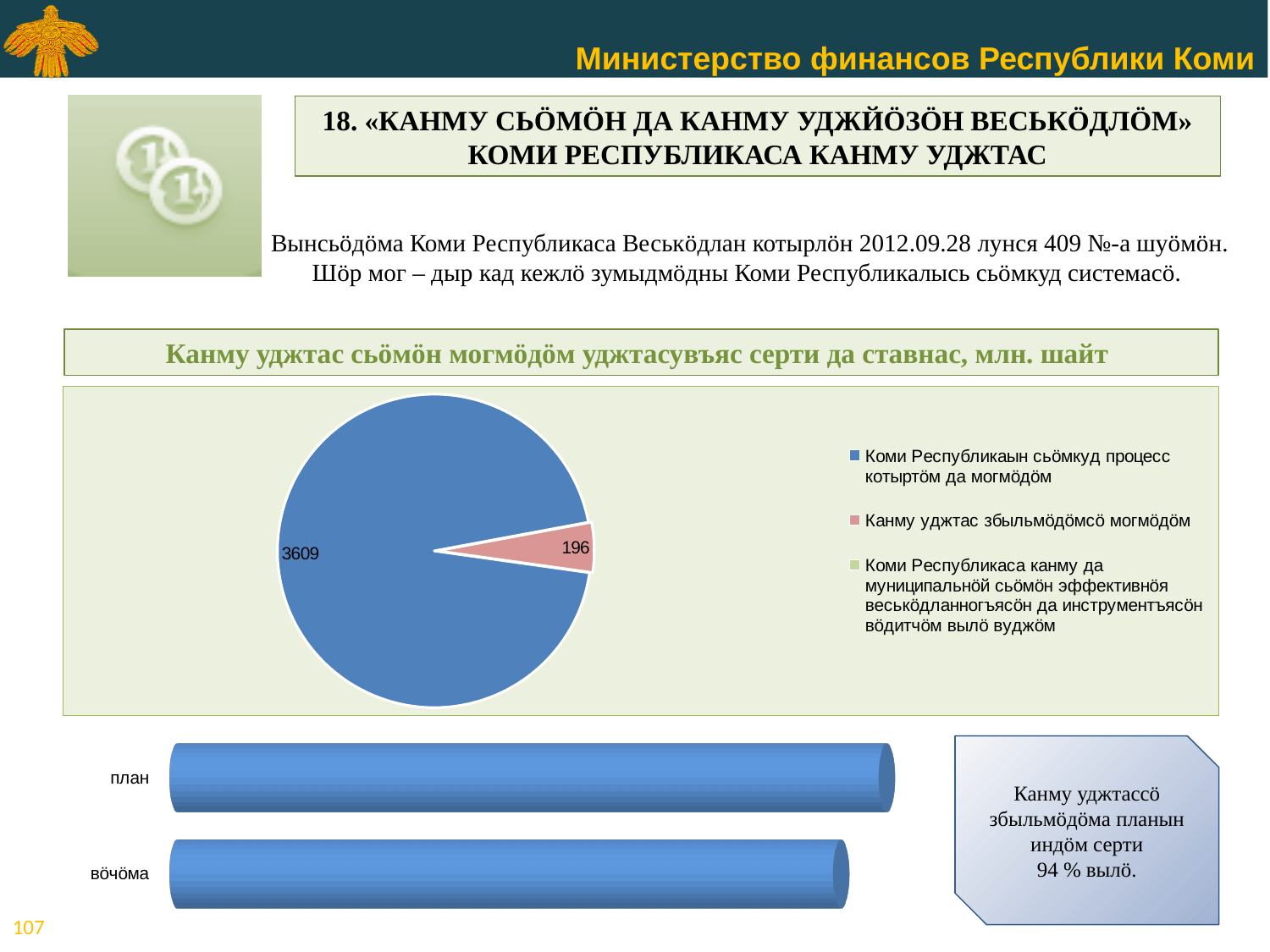
What kind of chart is the chart at the bottom of the slide with the categories «план» and «вöчöма»? Bar chart In the pie chart, what is the value for «Коми Республикаын сьöмкуд процесс котыртöм да могмöдöм»? 3609 How many entries does the legend of the pie chart list? 3 In the bar chart at the bottom of the slide, which bar is longer: «план» or «вöчöма»? план In the pie chart, what colour is the slice labelled 196? Pink In the pie chart, which is larger: the slice for «Коми Республикаын сьöмкуд процесс котыртöм да могмöдöм» or the slice for «Канму уджтас збыльмöдöмсö могмöдöм»? Коми Республикаын сьöмкуд процесс котыртöм да могмöдöм In the pie chart, which category has the largest slice? Коми Республикаын сьöмкуд процесс котыртöм да могмöдöм In the pie chart, what is the difference between the values 3609 and 196? 3413 How many categories does the bar chart at the bottom of the slide show? 2 What is the title shown above the pie chart? Канму уджтас сьöмöн могмöдöм уджтасувъяс серти да ставнас, млн. шайт What kind of chart is the chart in the middle of the slide? Pie chart In the pie chart, what is the value for «Канму уджтас збыльмöдöмсö могмöдöм»? 196